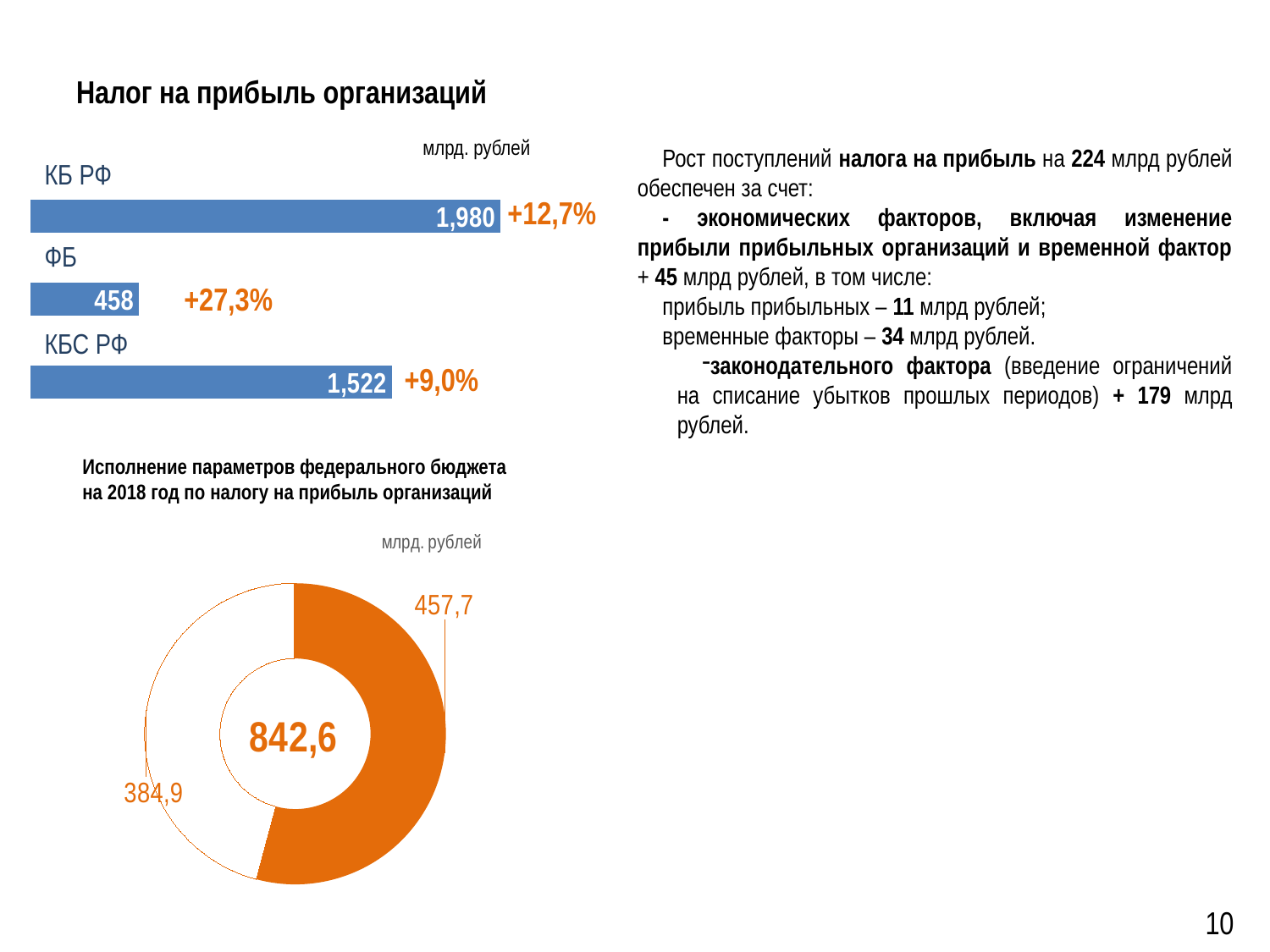
In the top-left bar chart, which category has the lowest value? ФБ In the top-left bar chart, what is the value for ФБ? 458 In the top-left bar chart, what growth percentage is shown next to the ФБ bar? +27,3% In the top-left bar chart, what is the value for КБС РФ? 1,522 How many categories does the top-left bar chart show? 3 What kind of chart is the bottom-left chart titled 'Исполнение параметров федерального бюджета на 2018 год по налогу на прибыль организаций'? doughnut chart In the bottom-left doughnut chart, what total is shown in the centre? 842,6 In the top-left bar chart, what is the difference between the values for КБ РФ and КБС РФ? 458 In the top-left bar chart, what is the value for КБ РФ? 1,980 What kind of chart is the top-left chart on the slide (КБ РФ, ФБ, КБС РФ)? bar chart In the bottom-left doughnut chart, what is the value of the orange segment? 457,7 In the top-left bar chart, which category has the highest value? КБ РФ